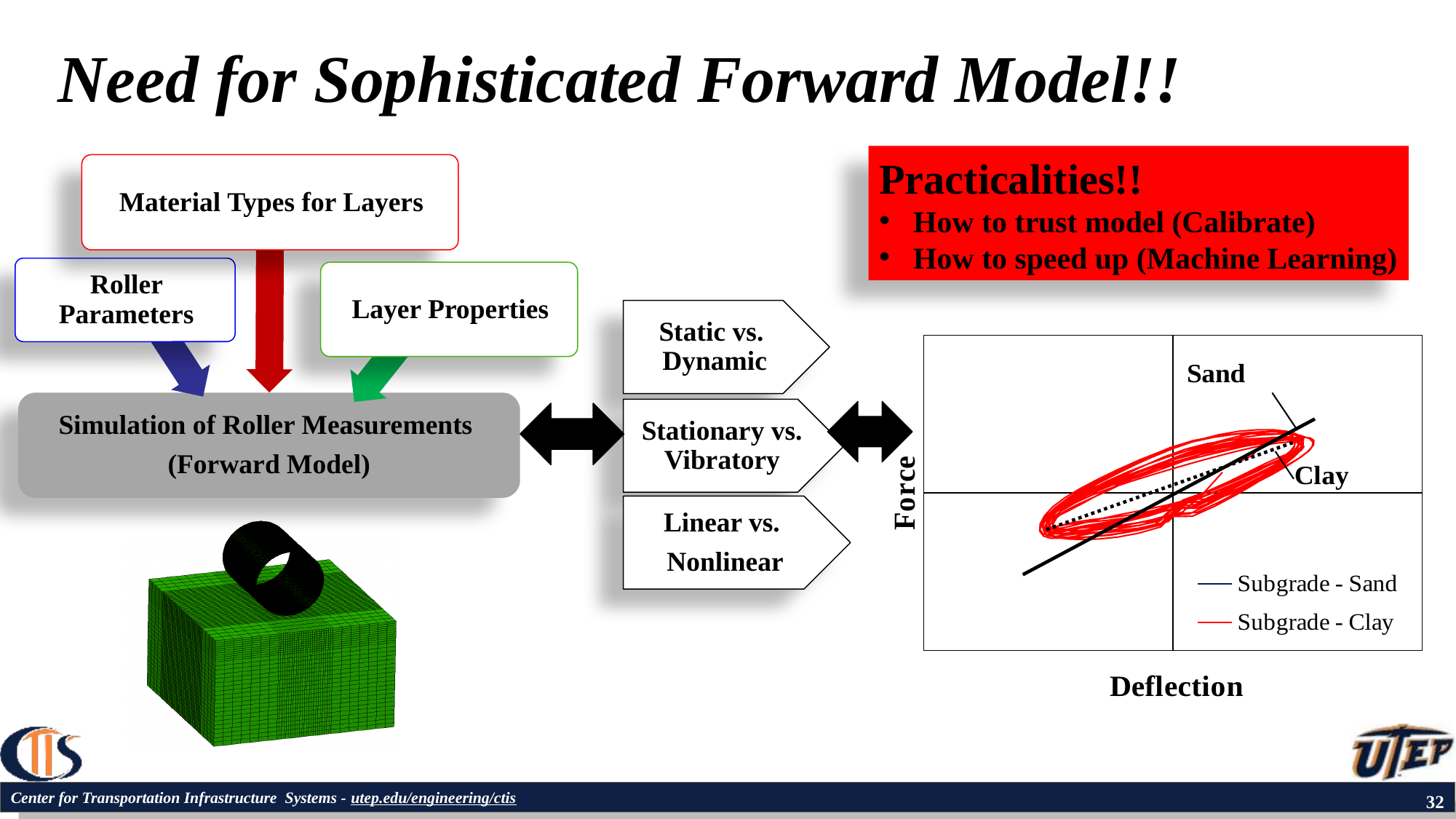
What is the label of the vertical axis of the chart on the right? Force What kind of chart is shown on the right side of the slide? line chart How many series does the legend of the Force vs. Deflection chart list? 2 In the Force vs. Deflection chart, which subgrade material is represented by the looping (hysteresis) curve? Clay In the Force vs. Deflection chart, which series is drawn as a straight black line? Subgrade - Sand What is the label of the horizontal axis of the chart on the right? Deflection In the Force vs. Deflection chart, which series is drawn in red? Subgrade - Clay In the Force vs. Deflection chart, does force rise or fall as deflection increases along the Sand line? rise